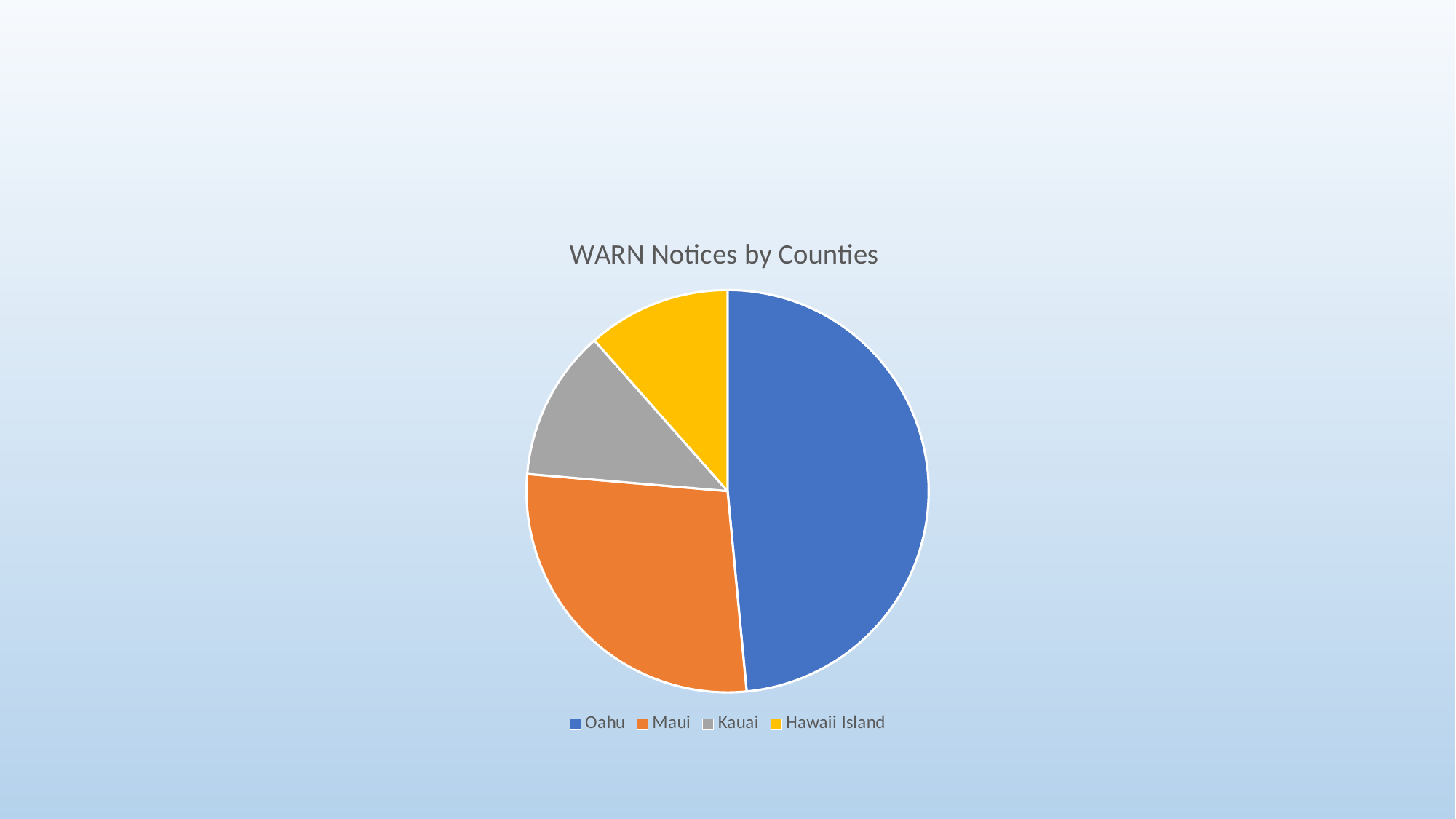
How many counties (slices) does the pie chart show? 4 What kind of chart is shown on the slide? pie chart Which slice is larger, Oahu or Maui? Oahu Which slice is larger, Maui or Kauai? Maui Which slice is larger, Hawaii Island or Oahu? Oahu Which county is represented by the blue slice? Oahu What is the title of the chart? WARN Notices by Counties Which county has the largest slice of the pie? Oahu How many entries does the legend list? 4